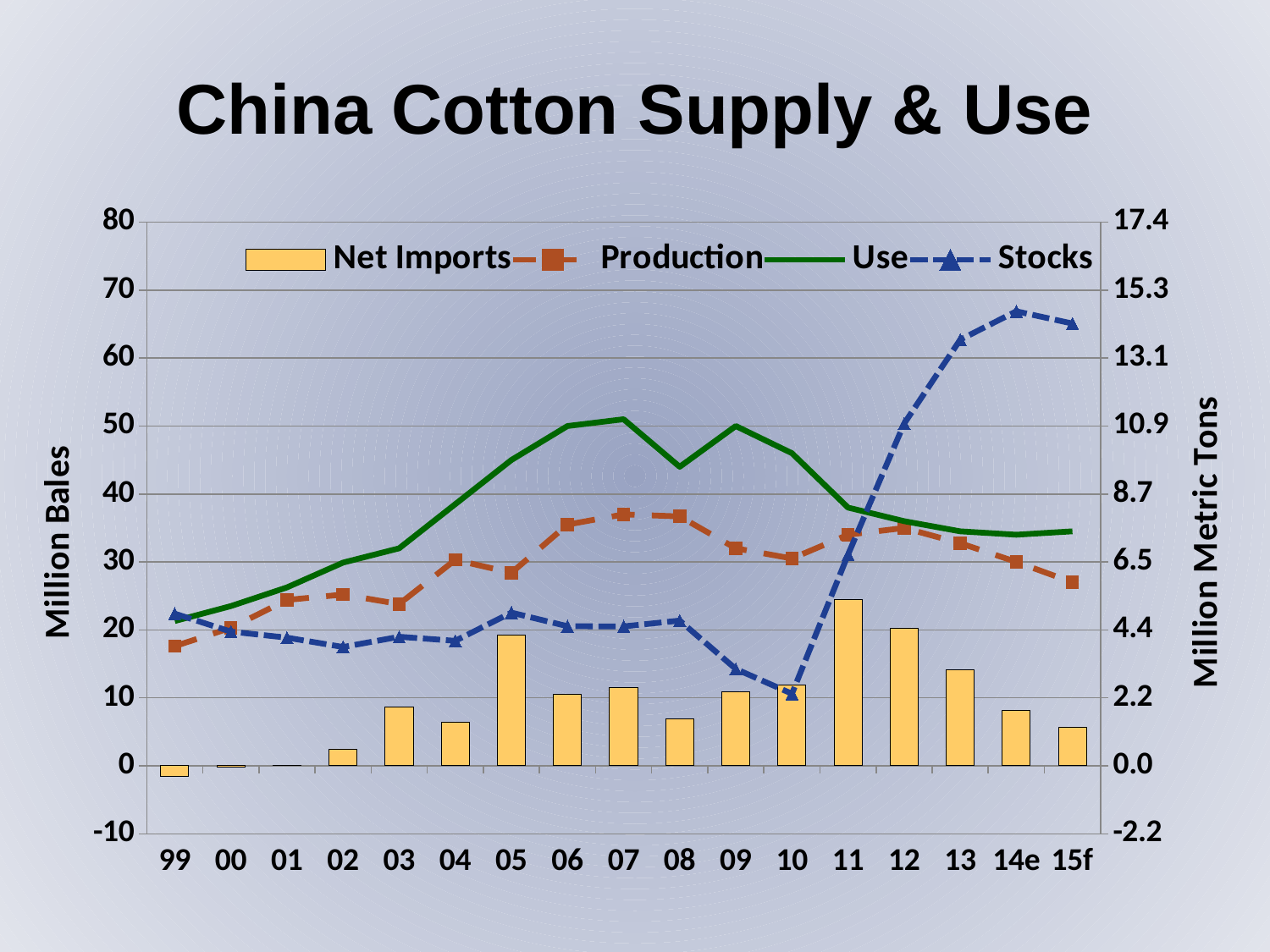
In which year are Stocks highest? 14e In which year are Net Imports highest? 11 In which year are Stocks lowest? 10 Is the value for Production in 99 greater or less than 20 million bales? less In 07, which is larger, Use or Production? Use How many years are shown along the x axis? 17 What kind of chart is shown on the slide? A combination bar and line chart What is the label of the right-hand vertical axis? Million Metric Tons Is the value for Stocks in 14e greater or less than 60 million bales? greater Is the value for Net Imports in 11 greater or less than 20 million bales? greater How many series does the legend list? 4 Do Stocks rise or fall from 10 to 14e? Rise